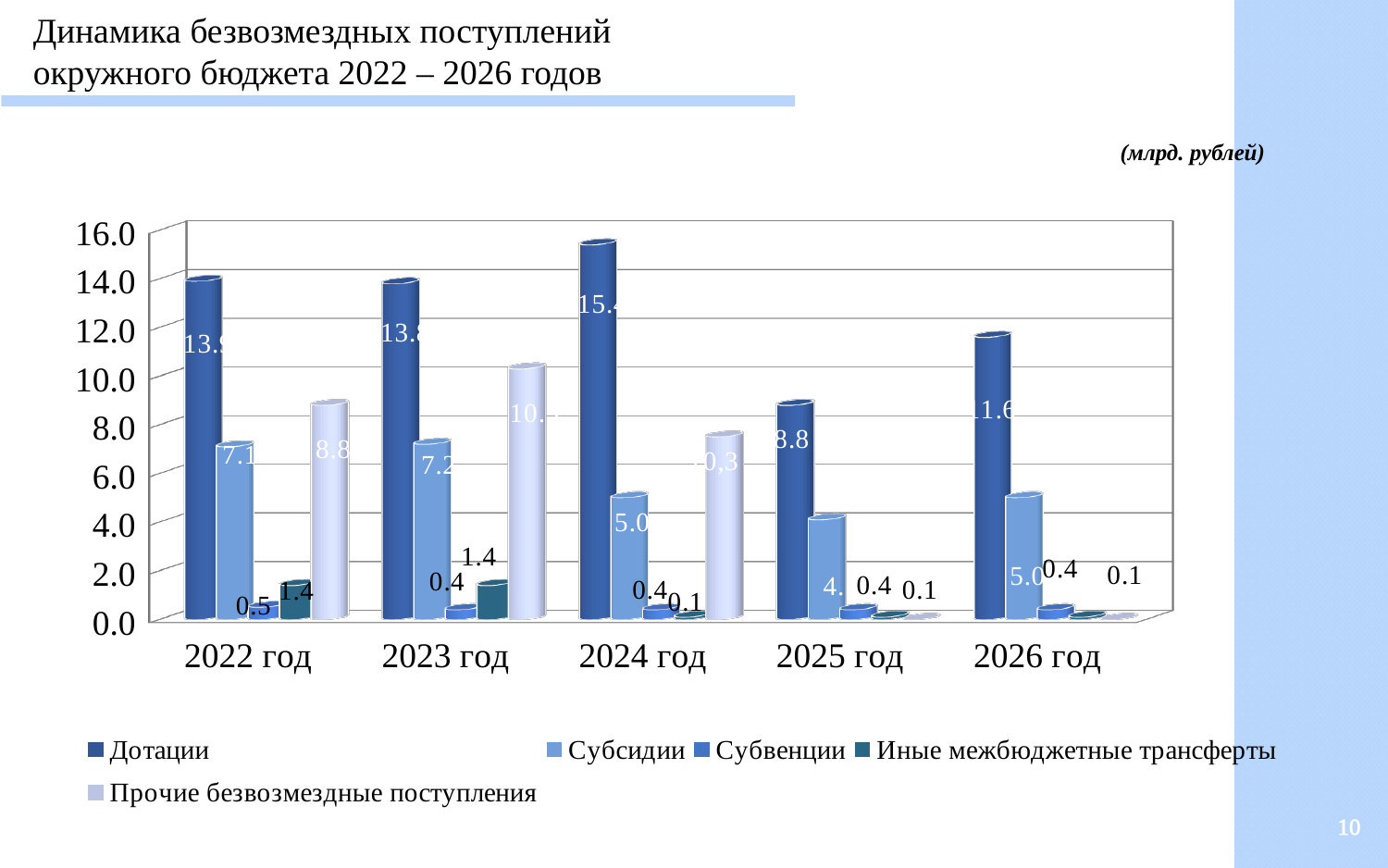
How many series does the legend list? 5 What kind of chart is shown on the slide? Bar chart How many years (categories) are shown on the x axis? 5 What unit of measurement is indicated for the chart values? млрд. рублей In which year is the value of Дотации the highest? 2024 год What is the value of Дотации for 2024 год? 15.4 What is the value of Прочие безвозмездные поступления for 2022 год? 8.8 Is the value of Прочие безвозмездные поступления for 2023 год greater or less than 8.0? greater What is the value of Дотации for 2022 год? 13.9 What is the difference between Дотации in 2024 год and Дотации in 2025 год? 6.6 In which year is the value of Дотации the lowest? 2025 год What is the value of Субсидии for 2023 год? 7.2